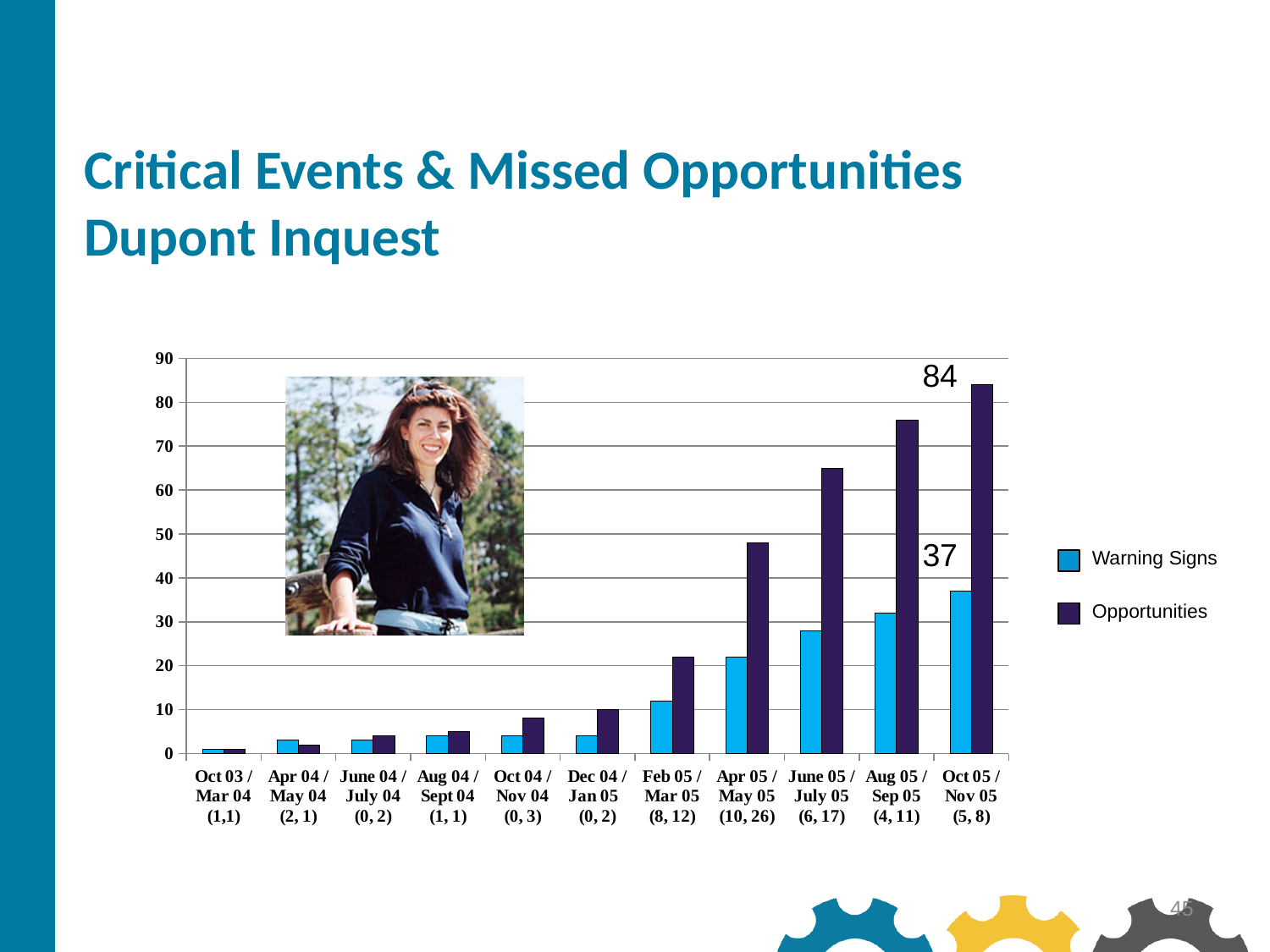
How many periods are shown on the x axis? 11 Which period has the highest Warning Signs value? Oct 05 / Nov 05 What is the difference between the Opportunities and Warning Signs values for Oct 05 / Nov 05? 47 What is the value of the Warning Signs bar for Oct 05 / Nov 05? 37 What kind of chart is shown on the slide? Bar chart Is the Warning Signs value for Feb 05 / Mar 05 greater or less than 20? less Do the Opportunities values generally rise or fall from Oct 03 / Mar 04 to Oct 05 / Nov 05? Rise What is the value of the Opportunities bar for Oct 05 / Nov 05? 84 Is the Opportunities value for Apr 05 / May 05 greater or less than 40? greater How many series does the legend list? 2 Which period has the highest Opportunities value? Oct 05 / Nov 05 Which colour represents Warning Signs in the legend? Light blue